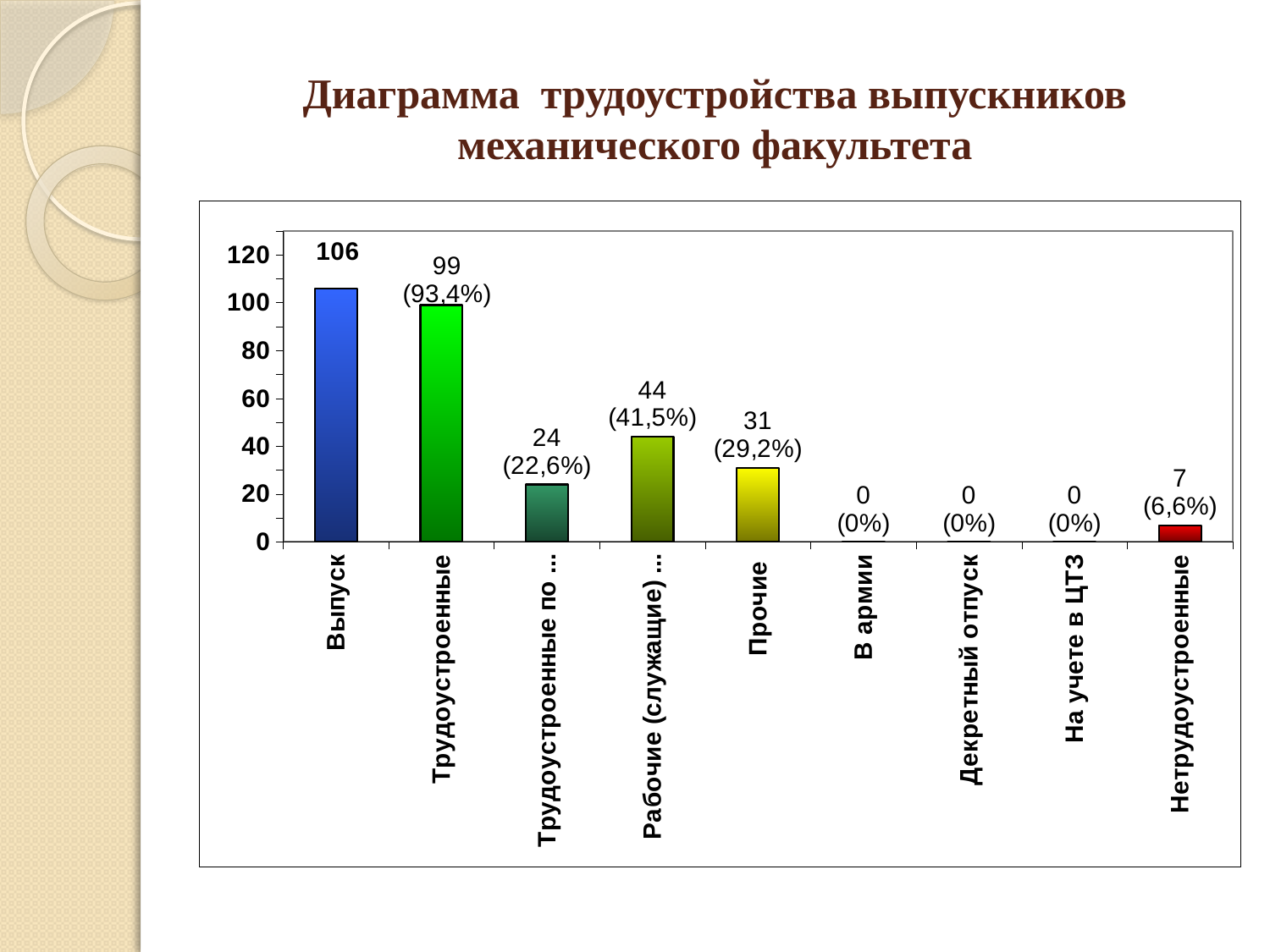
How many categories are shown on the x axis? 9 What is the value for Трудоустроенные? 99 What is the value for Прочие? 31 Which category has the highest value? Выпуск What is the title of the slide? Диаграмма трудоустройства выпускников механического факультета What percentage is shown for Нетрудоустроенные? 6,6% What is the difference between the values for Выпуск and Трудоустроенные? 7 What is the value for Выпуск? 106 Is the value for Трудоустроенные greater or less than 80? greater What kind of chart is shown on the slide? bar chart Which is larger, the value for Прочие or the value for Нетрудоустроенные? Прочие What is the value for В армии? 0